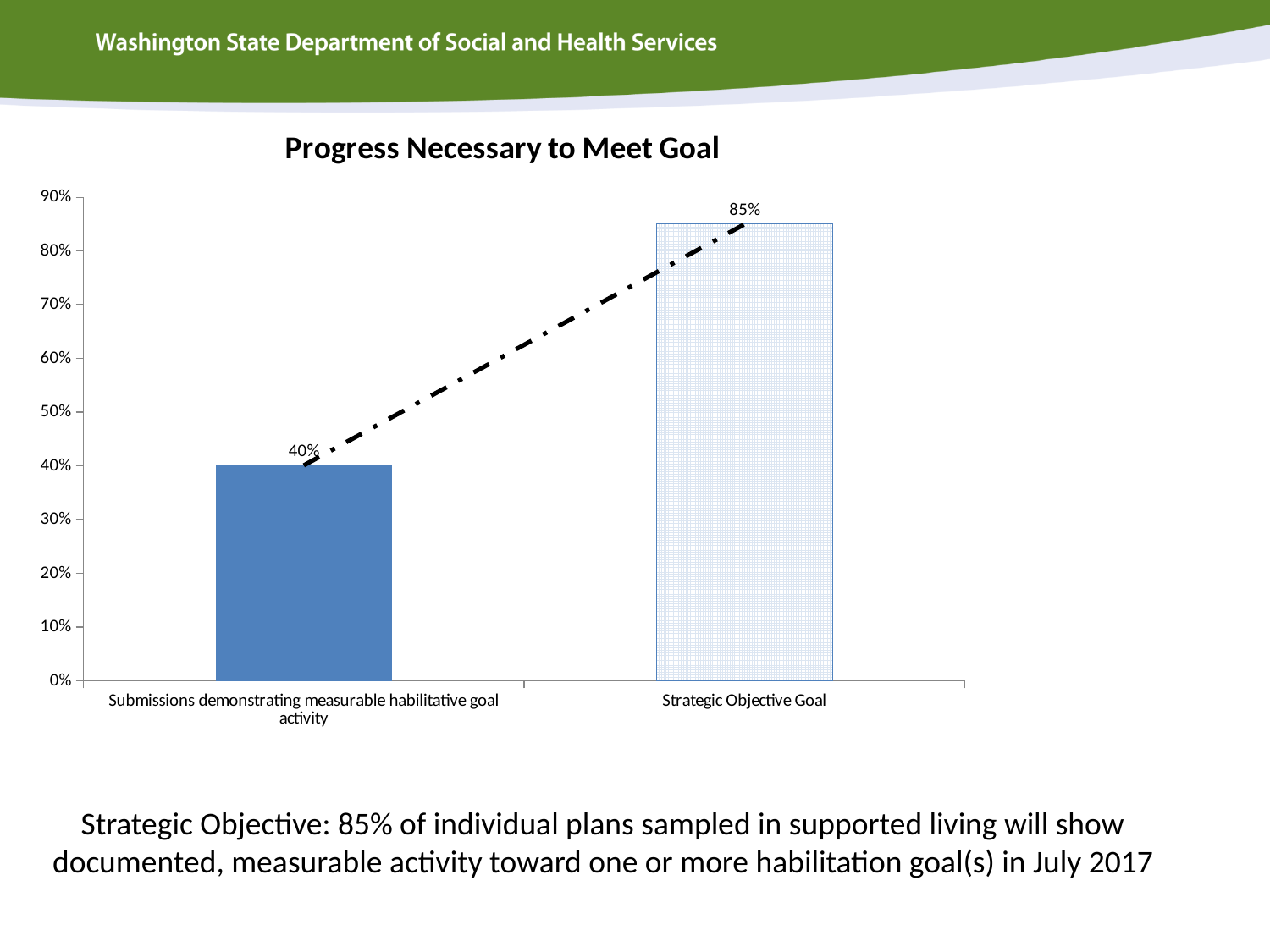
What is the difference between the Strategic Objective Goal and the Submissions demonstrating measurable habilitative goal activity values? 45% Is the value for Submissions demonstrating measurable habilitative goal activity greater or less than 50%? less How many categories are shown on the x axis? 2 What is the title of the chart? Progress Necessary to Meet Goal Which category has the highest value? Strategic Objective Goal What is the highest value shown on the y axis? 90% What kind of chart is shown on the slide? Bar chart What is the value for Submissions demonstrating measurable habilitative goal activity? 40% Which category has the lowest value? Submissions demonstrating measurable habilitative goal activity What is the value for Strategic Objective Goal? 85% Which is larger, the value for Strategic Objective Goal or the value for Submissions demonstrating measurable habilitative goal activity? Strategic Objective Goal Is the value for Strategic Objective Goal greater or less than 80%? greater